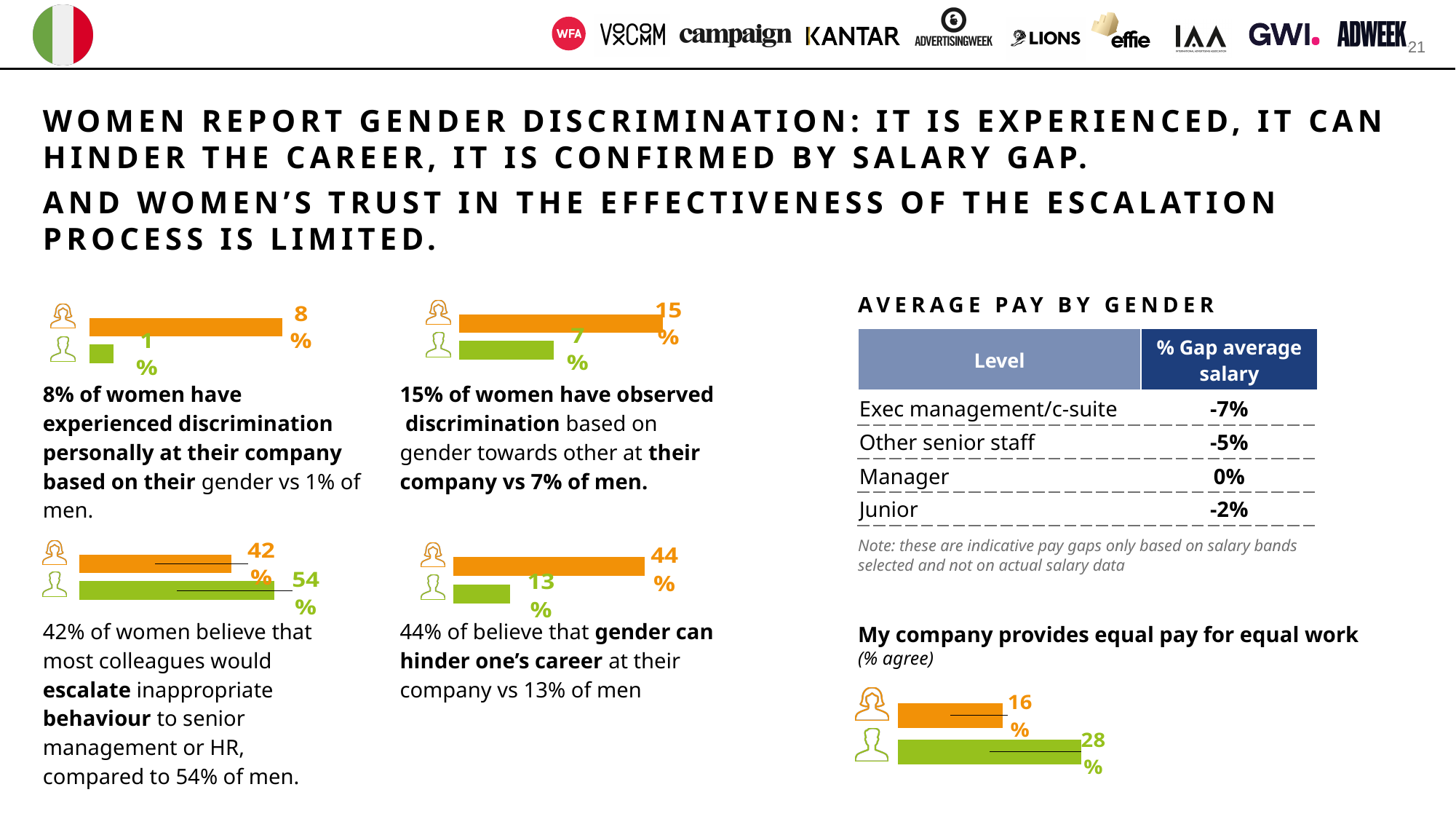
In the chart titled 'My company provides equal pay for equal work', which group has the larger value? Men In the top-left chart about women who have experienced discrimination personally, what is the value for women? 8% What type of chart is used for 'My company provides equal pay for equal work'? Bar chart In the top-left chart about women who have experienced discrimination personally, what is the value for men? 1% In the chart titled 'My company provides equal pay for equal work', what is the value for women? 16% In the top-middle chart about observed discrimination, what is the difference between the women's and men's values? 8% In the chart titled 'My company provides equal pay for equal work', what is the value for men? 28% In the bottom-middle chart about gender hindering one's career, what is the value for women? 44% In the chart titled 'My company provides equal pay for equal work', what colour is the bar for women? Orange In the bottom-left chart about escalating inappropriate behaviour, which group has the higher value, women or men? Men In the bottom-left chart about escalating inappropriate behaviour, what is the value for men? 54% In the bottom-middle chart about gender hindering one's career, what is the difference between the women's and men's values? 31%